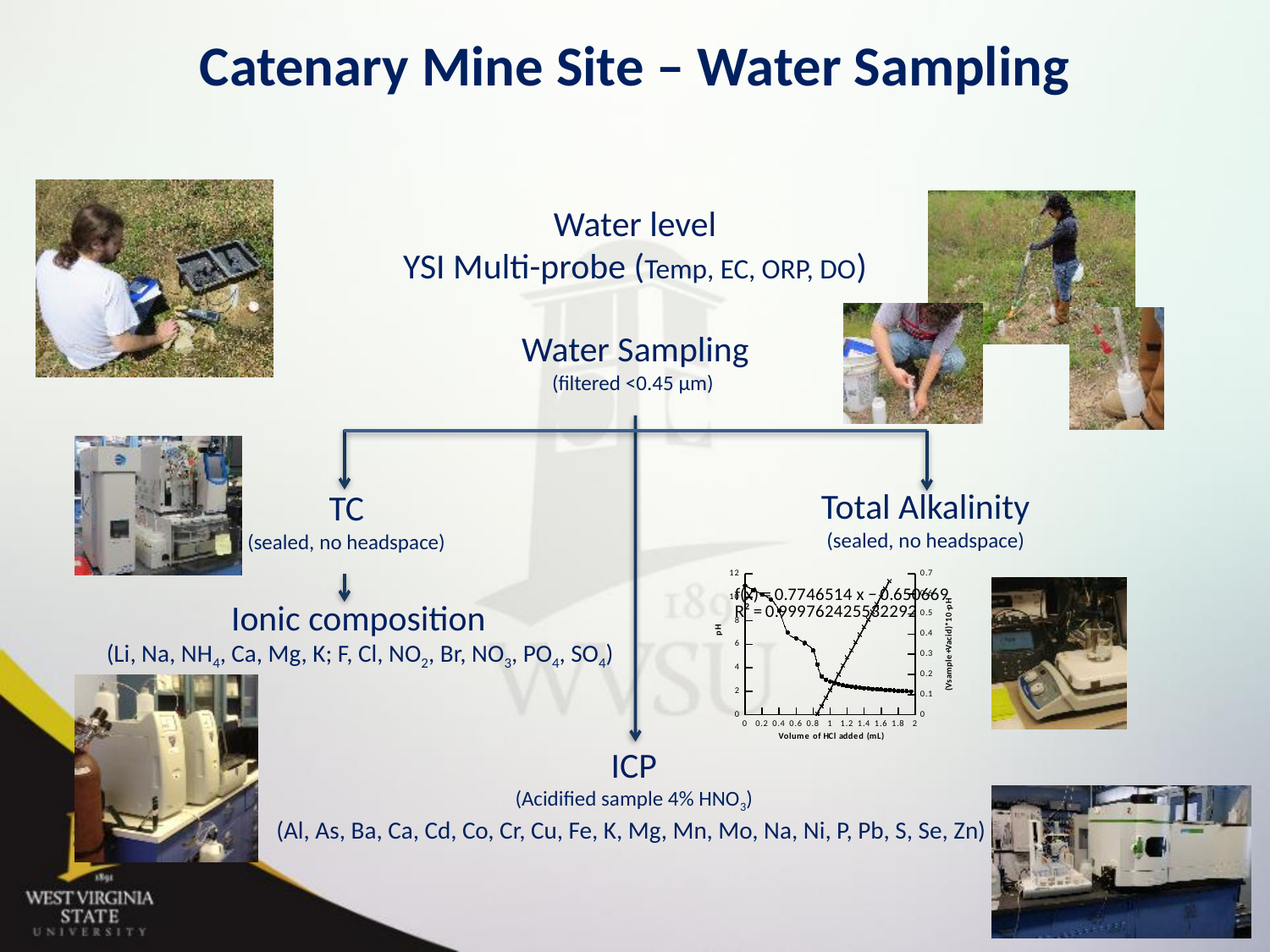
Does the pH series rise or fall as the volume of HCl added increases? fall What is the maximum value shown on the left y axis (pH) of the chart? 12 Is the pH value at 2 mL of HCl added greater or less than 4? less What kind of chart is shown on the slide? line chart Is the pH value at 0 mL of HCl added greater or less than 8? greater What is the slope in the fitted equation printed on the chart, f(x) = ?x − 0.650669? 0.7746514 What R² value is printed on the chart? 0.999762425582292 What is the label of the left y axis of the chart? pH What is the maximum value shown on the right y axis of the chart? 0.7